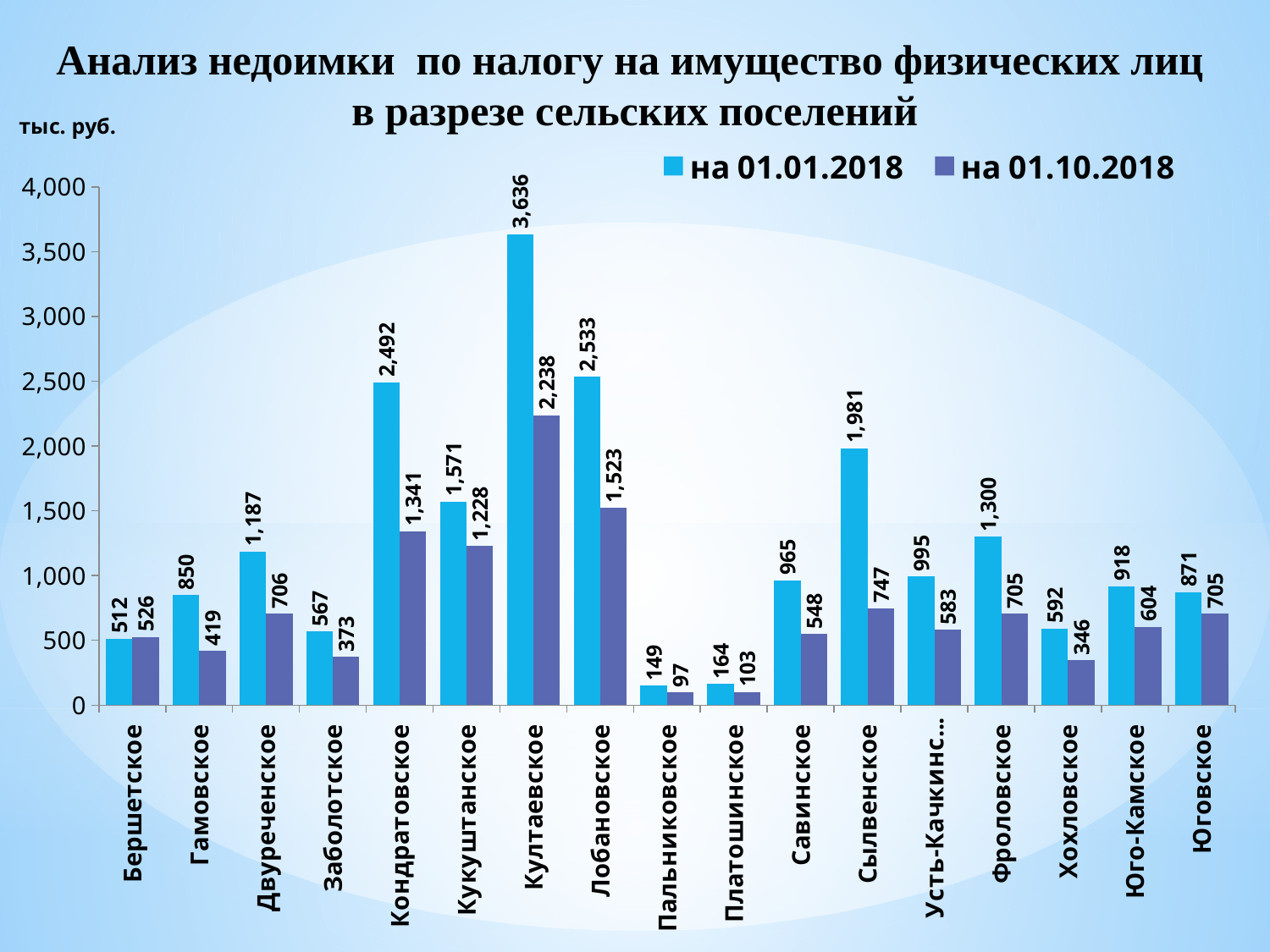
Which is larger for Бершетское: the value на 01.01.2018 or на 01.10.2018? на 01.10.2018 How many series does the legend list? 2 Which has the larger value in the series на 01.01.2018: Фроловское or Двуреченское? Фроловское Which category has the highest value in the series на 01.10.2018? Култаевское What is the difference between the на 01.01.2018 and на 01.10.2018 values for Кондратовское? 1,151 How many categories (settlements) are shown on the x axis? 17 What is the value for Култаевское in the series на 01.01.2018? 3,636 What is the value for Сылвенское in the series на 01.01.2018? 1,981 What is the value for Лобановское in the series на 01.10.2018? 1,523 What is the difference between the на 01.01.2018 and на 01.10.2018 values for Сылвенское? 1,234 What kind of chart is shown on the slide? Bar chart Which category has the lowest value in the series на 01.01.2018? Пальниковское